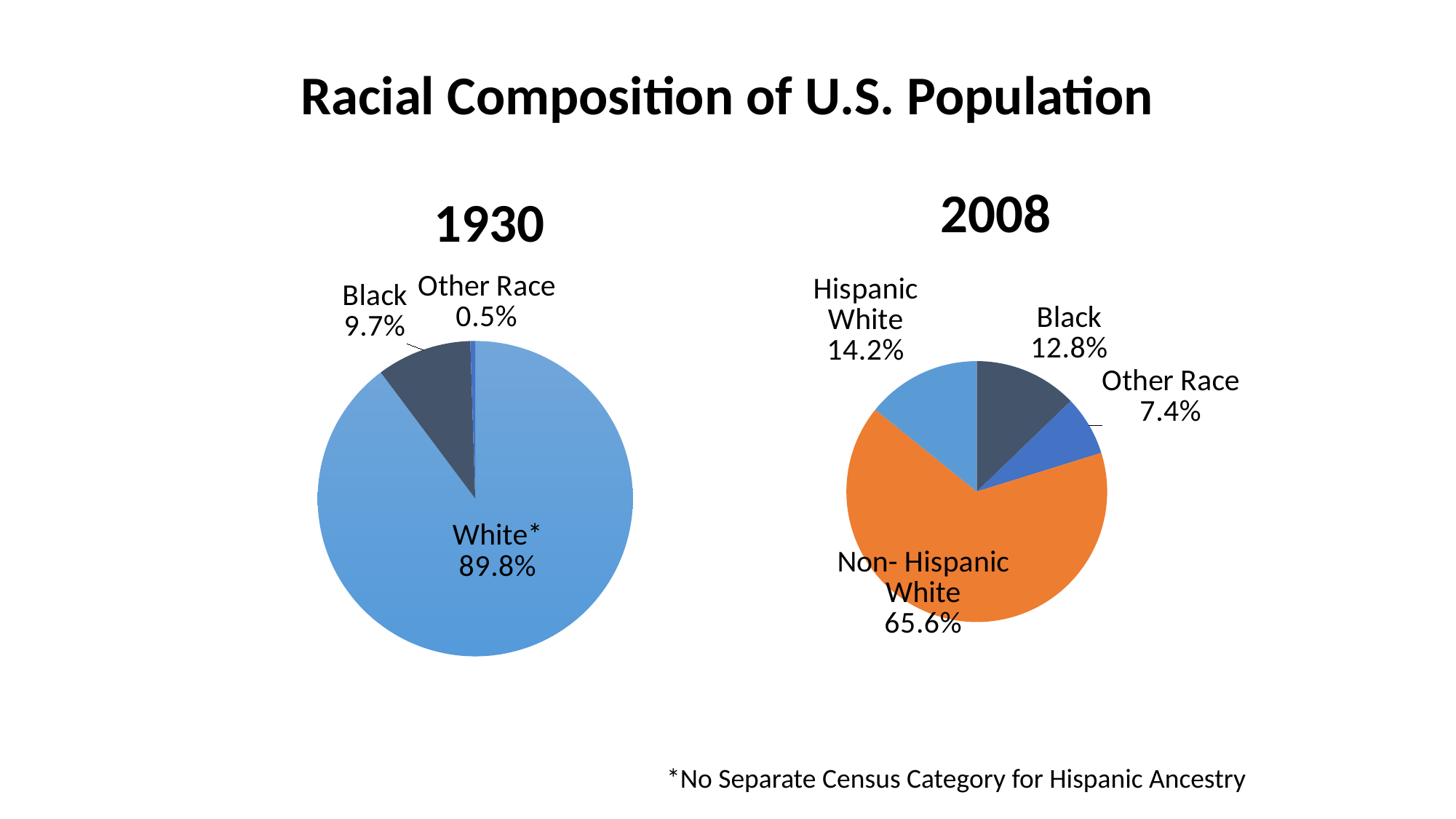
In the 2008 pie chart, which category has the smallest slice? Other Race In the 2008 pie chart, what percentage is shown for Other Race? 7.4% In the 2008 pie chart, what percentage is shown for Non-Hispanic White? 65.6% What type of chart is used for the 1930 data? Pie chart In the 2008 pie chart, what percentage is shown for Hispanic White? 14.2% In the 1930 pie chart, which category has the largest slice? White* How many categories does the 2008 pie chart show? 4 In the 2008 pie chart, what is the difference between the Black share and the Other Race share? 5.4% In the 1930 pie chart, what share of the U.S. population is labelled White*? 89.8% In the 1930 pie chart, what percentage is shown for Other Race? 0.5% In the 1930 pie chart, what percentage is shown for Black? 9.7% Which is larger in the 2008 pie chart: the Hispanic White slice or the Black slice? Hispanic White